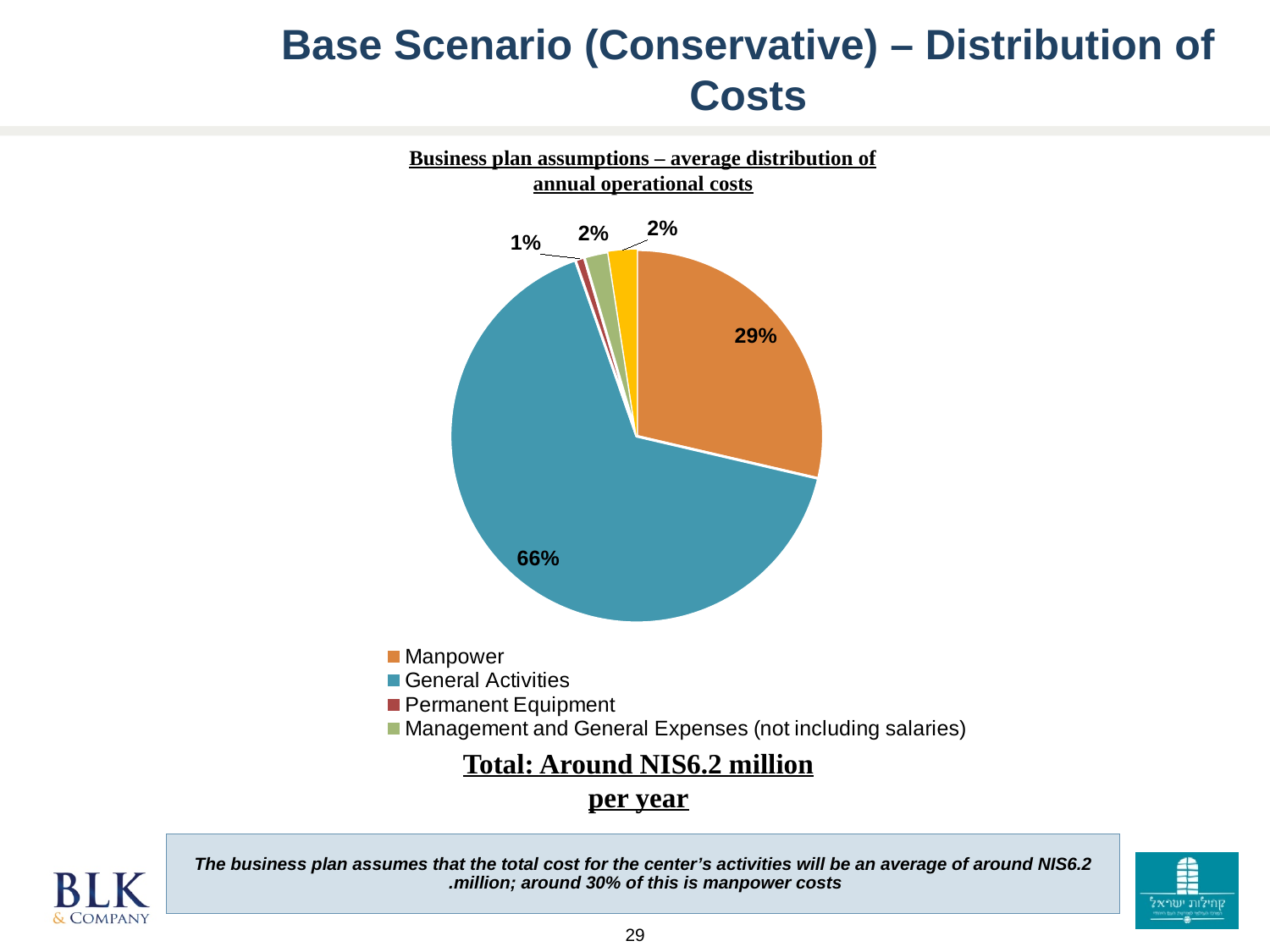
What share of annual operational costs is General Activities? 66% What share of annual operational costs is Permanent Equipment? 1% Which category has the smallest share of the pie? Permanent Equipment How many slices does the pie chart have? 5 How many percentage points larger is the General Activities share than the Manpower share? 37% What colour is the Manpower slice in the pie chart? orange What share of annual operational costs is Manpower? 29% What kind of chart is shown on the slide? pie chart How many entries does the chart legend list? 4 What share of annual operational costs is Management and General Expenses (not including salaries)? 2% Which category has the largest share of the pie? General Activities Which is larger, the Manpower share or the Permanent Equipment share? Manpower